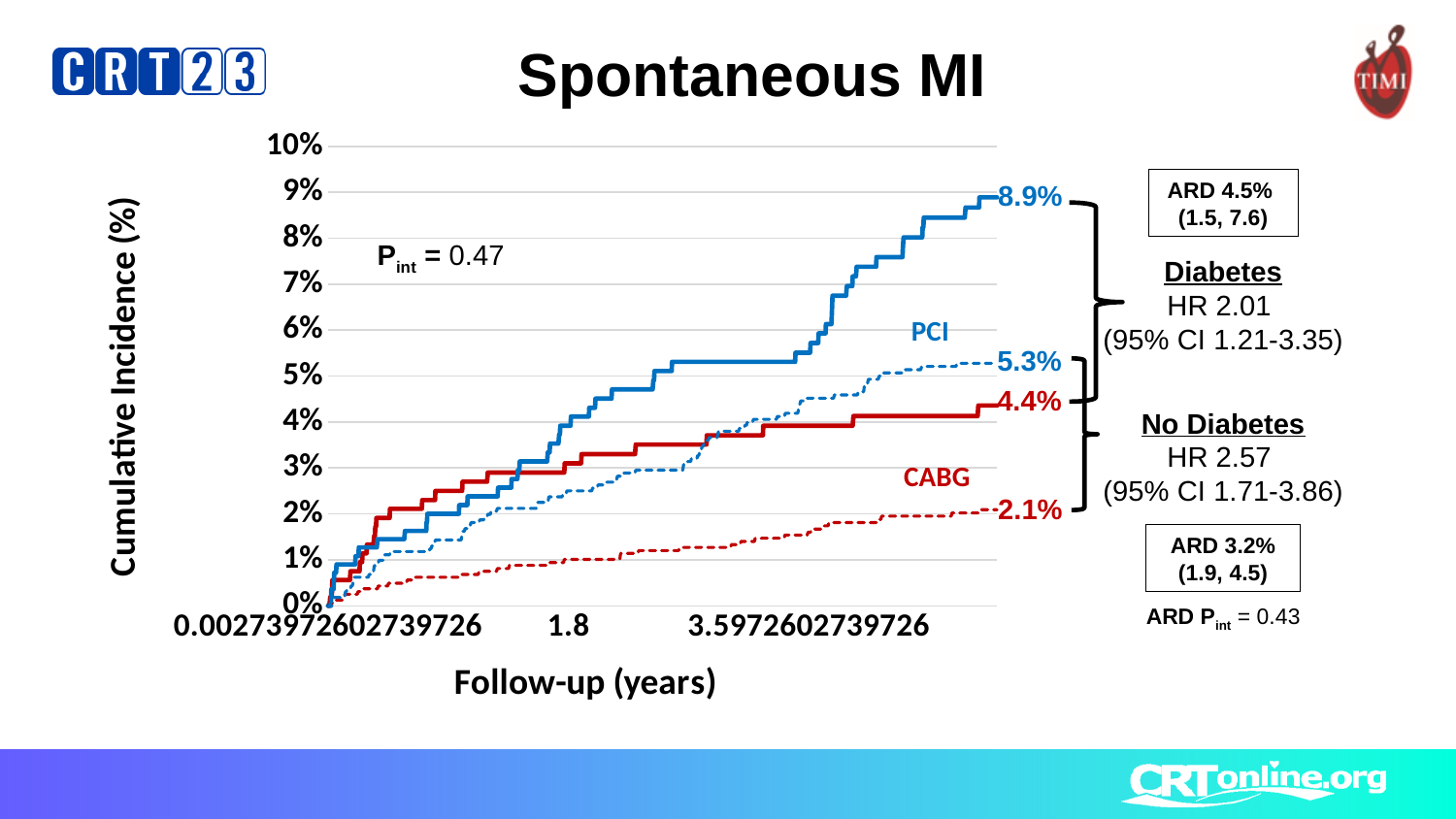
What is the title of the chart? Spontaneous MI What is the difference between the final values of the dashed PCI line (5.3%) and the dashed CABG line (2.1%)? 3.2% Which line ends with the lowest labelled cumulative incidence? dashed red CABG line (2.1%) Do the cumulative incidence lines rise or fall as follow-up time increases? rise What is the difference between the final values of the solid PCI line (8.9%) and the solid CABG line (4.4%)? 4.5% What kind of chart is shown on the slide? line chart What is the final cumulative incidence value labelled on the dashed red CABG line? 2.1% Is the value of the dashed red CABG line at 1.8 years greater or less than 2%? less What is the final cumulative incidence value labelled on the solid blue PCI line? 8.9% Which line ends with the highest labelled cumulative incidence? solid blue PCI line (8.9%) What is the final cumulative incidence value labelled on the solid red CABG line? 4.4% What is the final cumulative incidence value labelled on the dashed blue PCI line? 5.3%